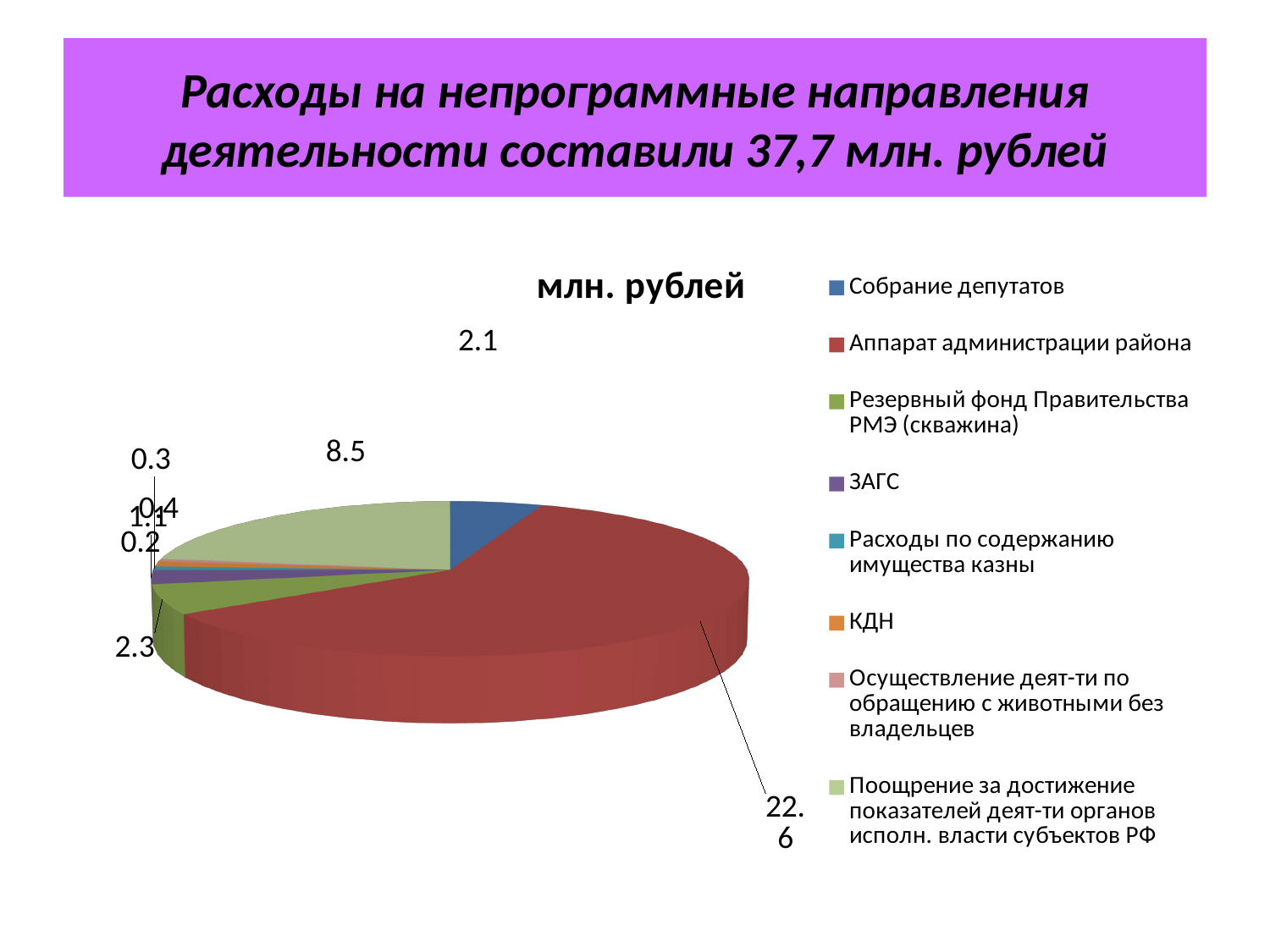
What colour is the slice for Аппарат администрации района? red What is the value for Поощрение за достижение показателей деят-ти органов исполн. власти субъектов РФ? 8.5 What is the difference between the values for Аппарат администрации района and Собрание депутатов? 20.5 What type of chart is shown on the slide? pie chart Which category has the largest slice of the pie? Аппарат администрации района What is the value for Аппарат администрации района? 22.6 Which is larger: the value for Поощрение за достижение показателей деят-ти органов исполн. власти субъектов РФ or the value for Собрание депутатов? Поощрение за достижение показателей деят-ти органов исполн. власти субъектов РФ What is the value for Собрание депутатов? 2.1 How many categories does the legend list? 8 What is the title of the chart? млн. рублей What is the difference between the values for Аппарат администрации района and Поощрение за достижение показателей деят-ти органов исполн. власти субъектов РФ? 14.1 What is the value for Резервный фонд Правительства РМЭ (скважина)? 2.3